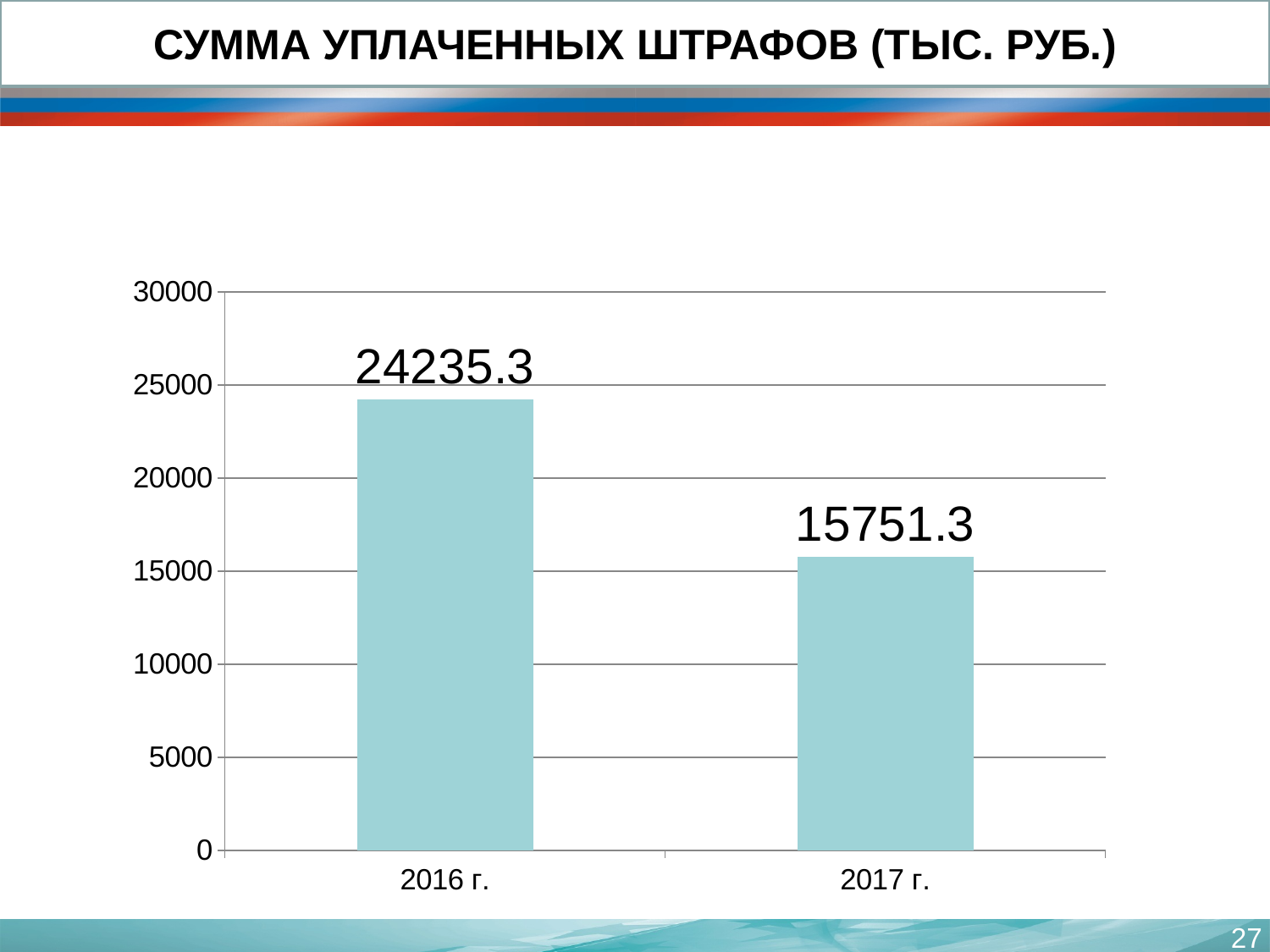
What kind of chart is shown on the slide? bar chart What is the difference between the values for 2016 г. and 2017 г.? 8484 Is the value for 2017 г. greater or less than 20000? less Do the values rise or fall from 2016 г. to 2017 г.? fall Which year has the lowest value? 2017 г. What is the title of the slide? СУММА УПЛАЧЕННЫХ ШТРАФОВ (ТЫС. РУБ.) Which year has the highest value? 2016 г. Which is larger, the value for 2016 г. or the value for 2017 г.? 2016 г. What is the value for 2017 г.? 15751.3 Is the value for 2016 г. greater or less than 20000? greater How many categories are shown on the chart? 2 What is the value for 2016 г.? 24235.3